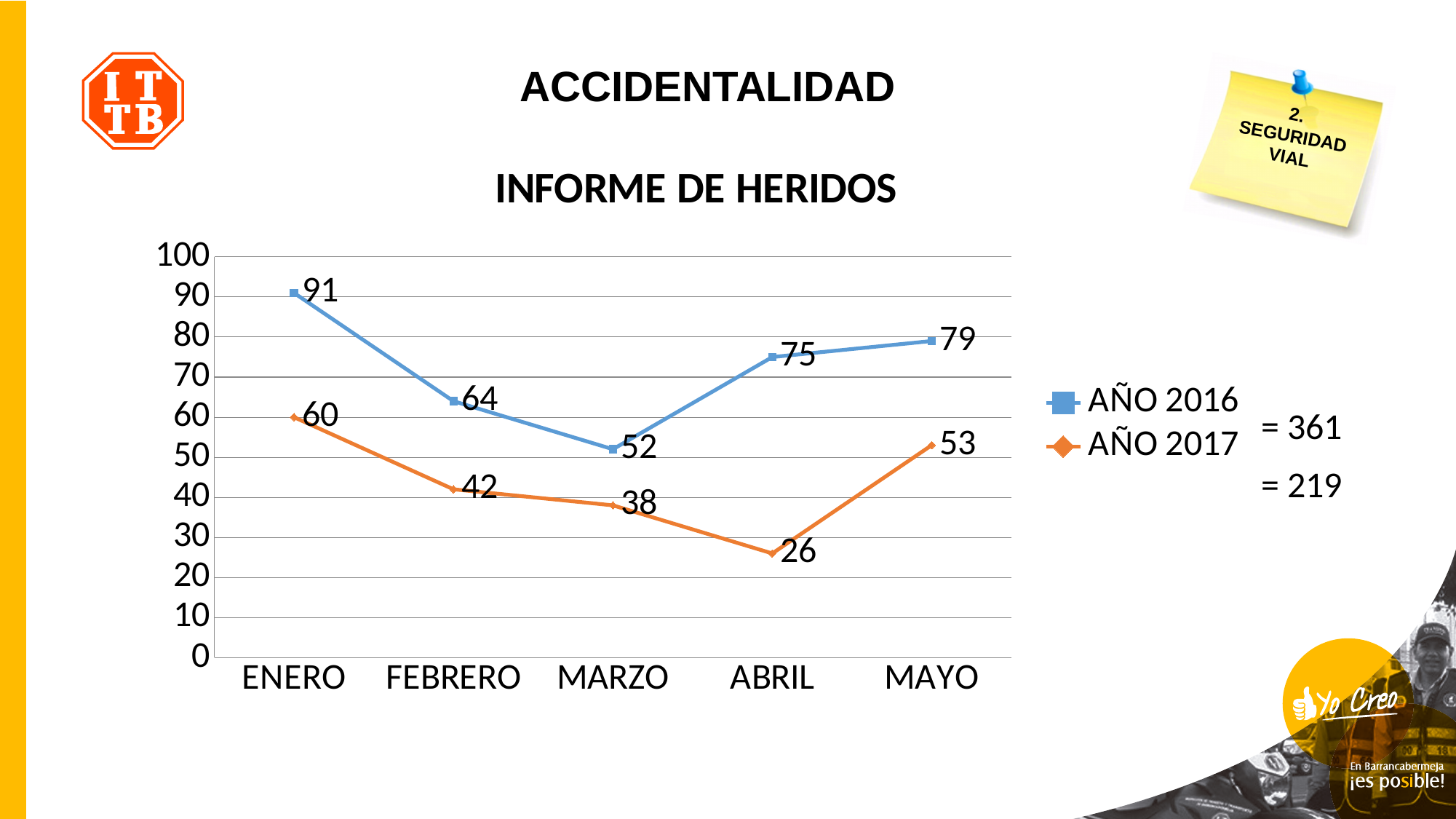
What is the value for AÑO 2017 in MAYO? 53 What is the value for AÑO 2016 in ENERO? 91 What kind of chart is shown? line chart In which month is the AÑO 2017 value highest? ENERO What is the difference between AÑO 2016 and AÑO 2017 in FEBRERO? 22 How many months are shown on the x axis? 5 What total is shown next to the legend for AÑO 2016? = 361 In which month is the AÑO 2016 value lowest? MARZO How many series does the legend list? 2 Does the AÑO 2017 series rise or fall from ENERO to ABRIL? fall What is the value for AÑO 2017 in ABRIL? 26 Which is larger in MARZO, AÑO 2016 or AÑO 2017? AÑO 2016